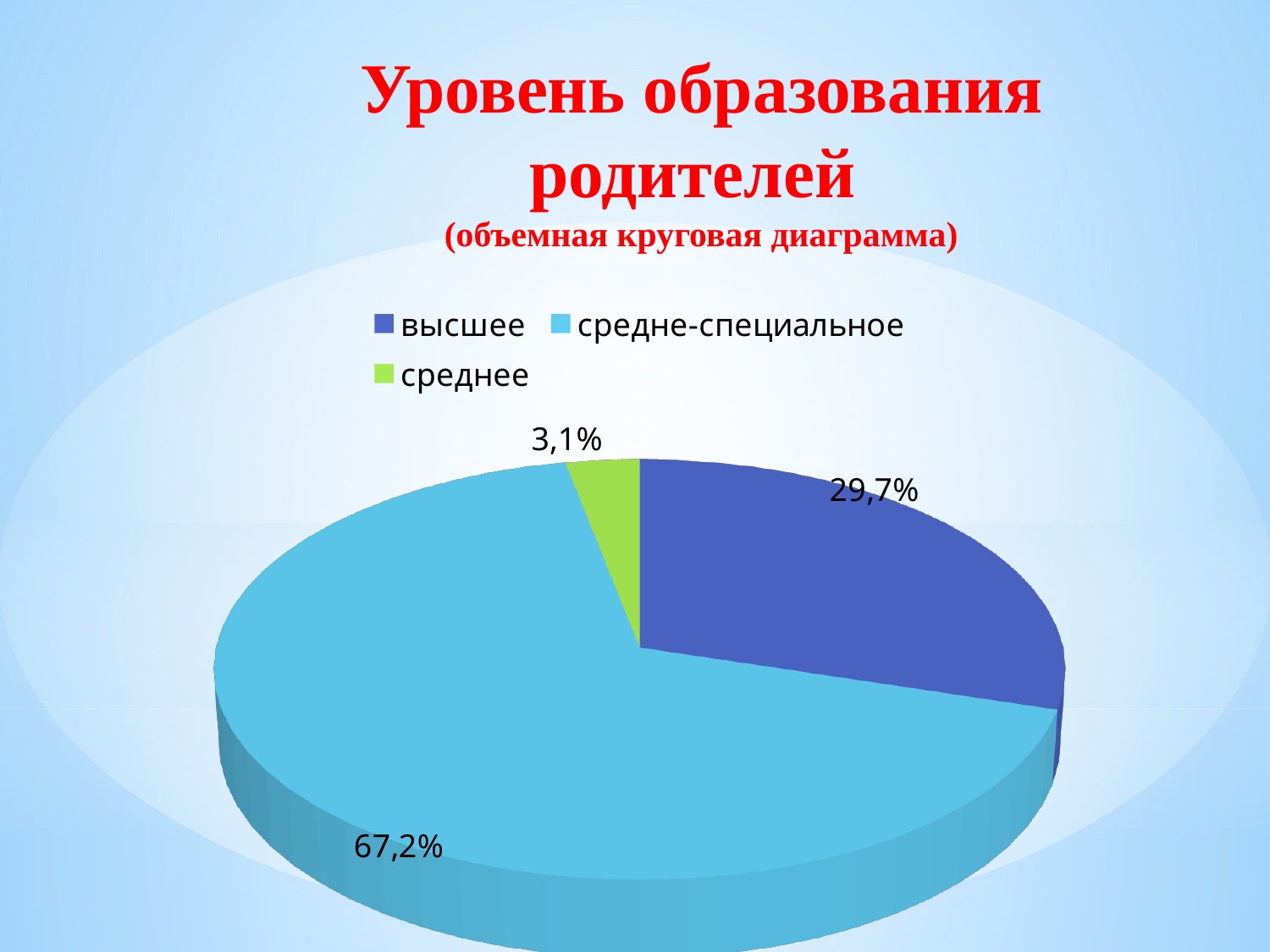
What share of the pie does the 'высшее' slice represent? 29,7% What is the difference in percentage points between the 'высшее' and 'среднее' slices? 26,6 How many entries does the legend list? 3 Which category has the largest slice of the pie? средне-специальное What kind of chart is shown on the slide? pie chart What is the difference in percentage points between the 'средне-специальное' and 'высшее' slices? 37,5 Which slice is larger, 'высшее' or 'среднее'? высшее What share of the pie does the 'средне-специальное' slice represent? 67,2% What share of the pie does the 'среднее' slice represent? 3,1% What is the title of the chart on the slide? Уровень образования родителей How many slices does the pie chart have? 3 Which category has the smallest slice of the pie? среднее